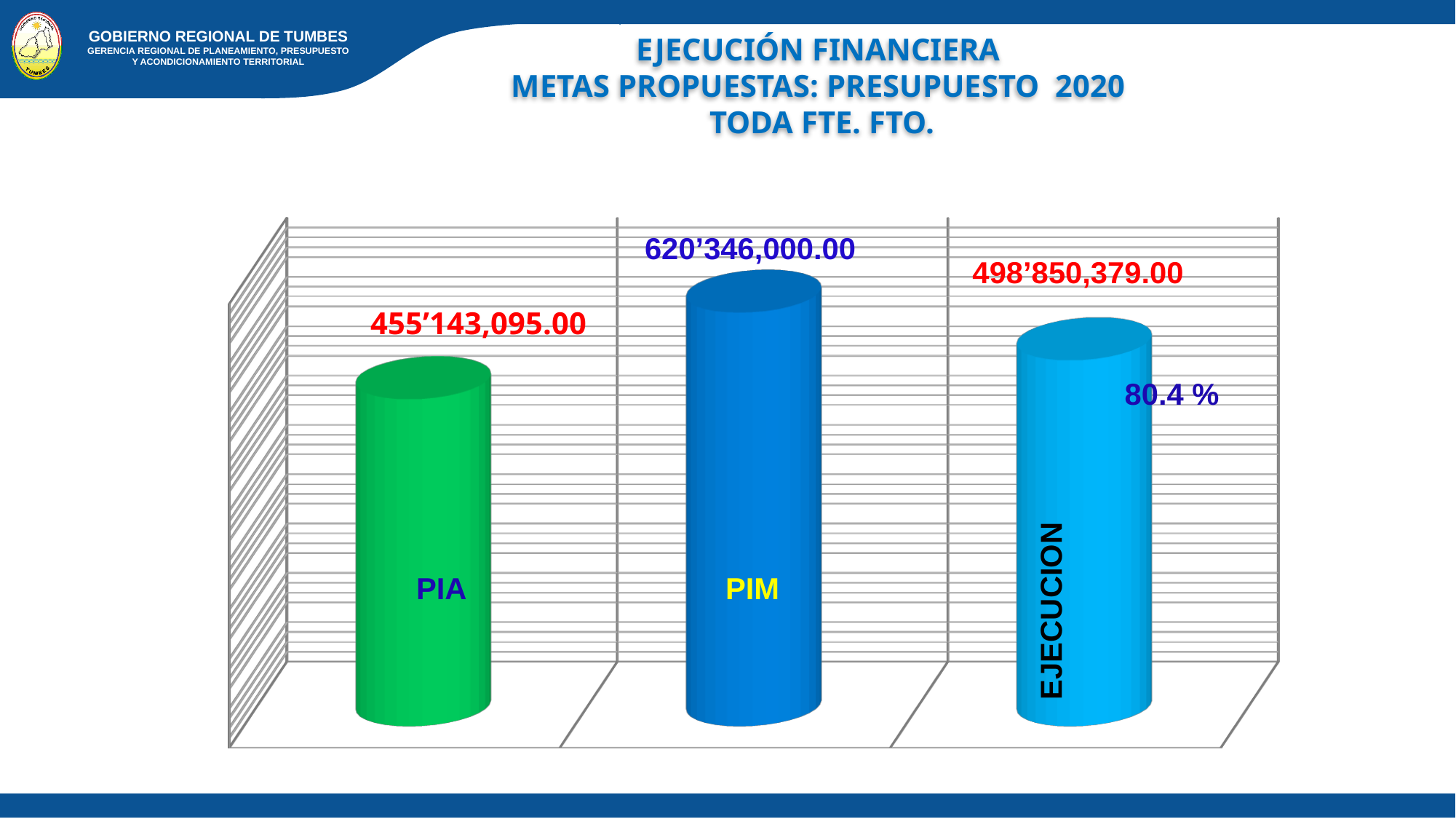
What is the difference between the PIM value and the PIA value? 165’202,905.00 Which category has the lowest value? PIA What colour is the PIA bar? Green Which category has the highest value? PIM What is the value shown for EJECUCION? 498’850,379.00 What is the value shown for PIA? 455’143,095.00 How many bars are plotted in the chart? 3 What percentage is shown next to the EJECUCION bar? 80.4 % What kind of chart is shown on the slide? Bar chart What is the difference between the PIM value and the EJECUCION value? 121’495,621.00 What is the value shown for PIM? 620’346,000.00 Which is larger, the value for EJECUCION or the value for PIA? EJECUCION